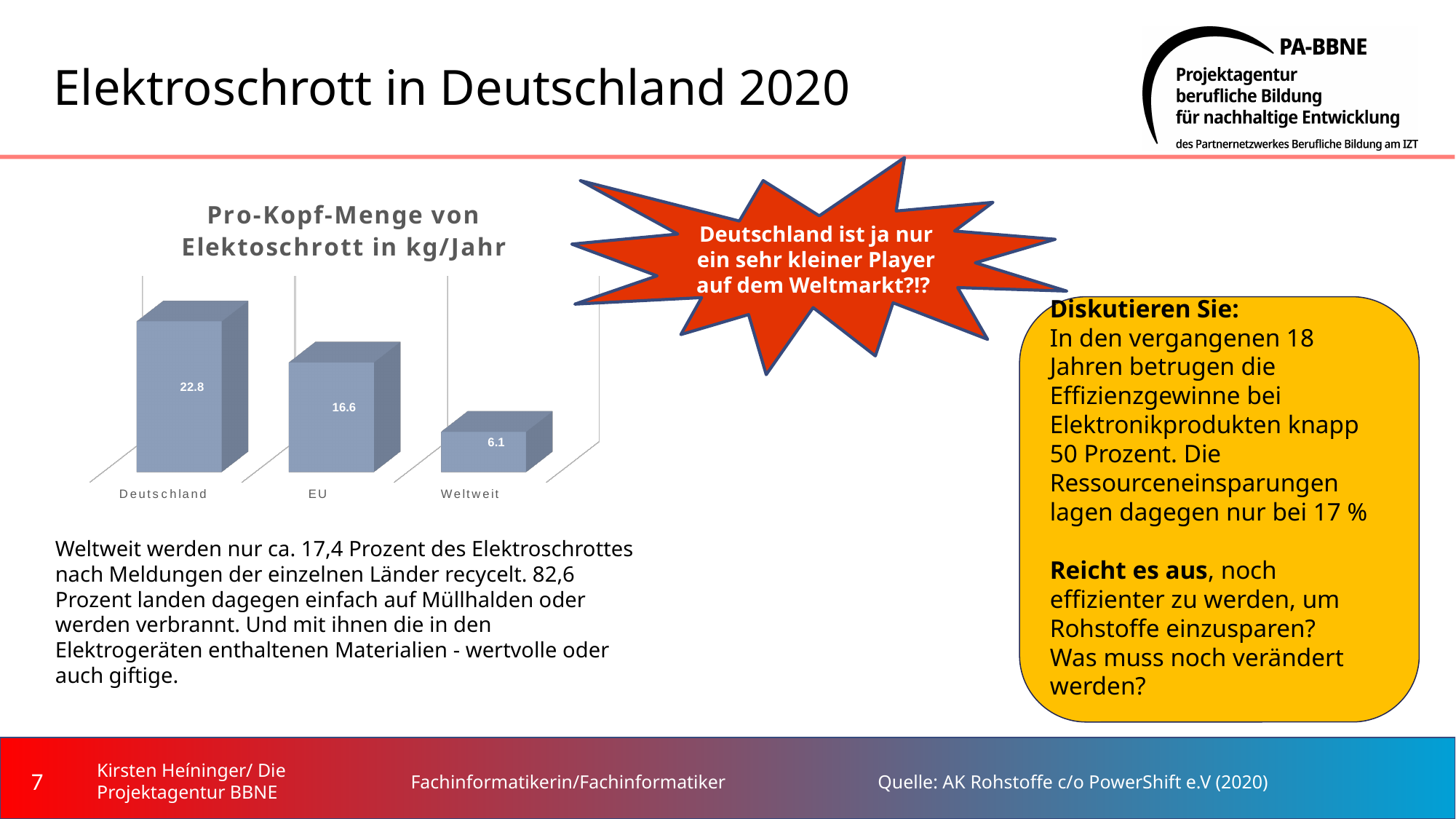
Which category has the highest value in the chart? Deutschland What is the title of the chart? Pro-Kopf-Menge von Elektoschrott in kg/Jahr How many categories are shown in the chart? 3 What is the value for Deutschland in the chart? 22.8 What is the value for EU in the chart? 16.6 Which category has the lowest value in the chart? Weltweit What kind of chart is shown on the slide? bar chart Do the values rise or fall from left to right across the categories? fall What is the difference between the values for Deutschland and EU? 6.2 What is the value for Weltweit in the chart? 6.1 What is the difference between the values for EU and Weltweit? 10.5 Which is larger, the value for EU or the value for Weltweit? EU